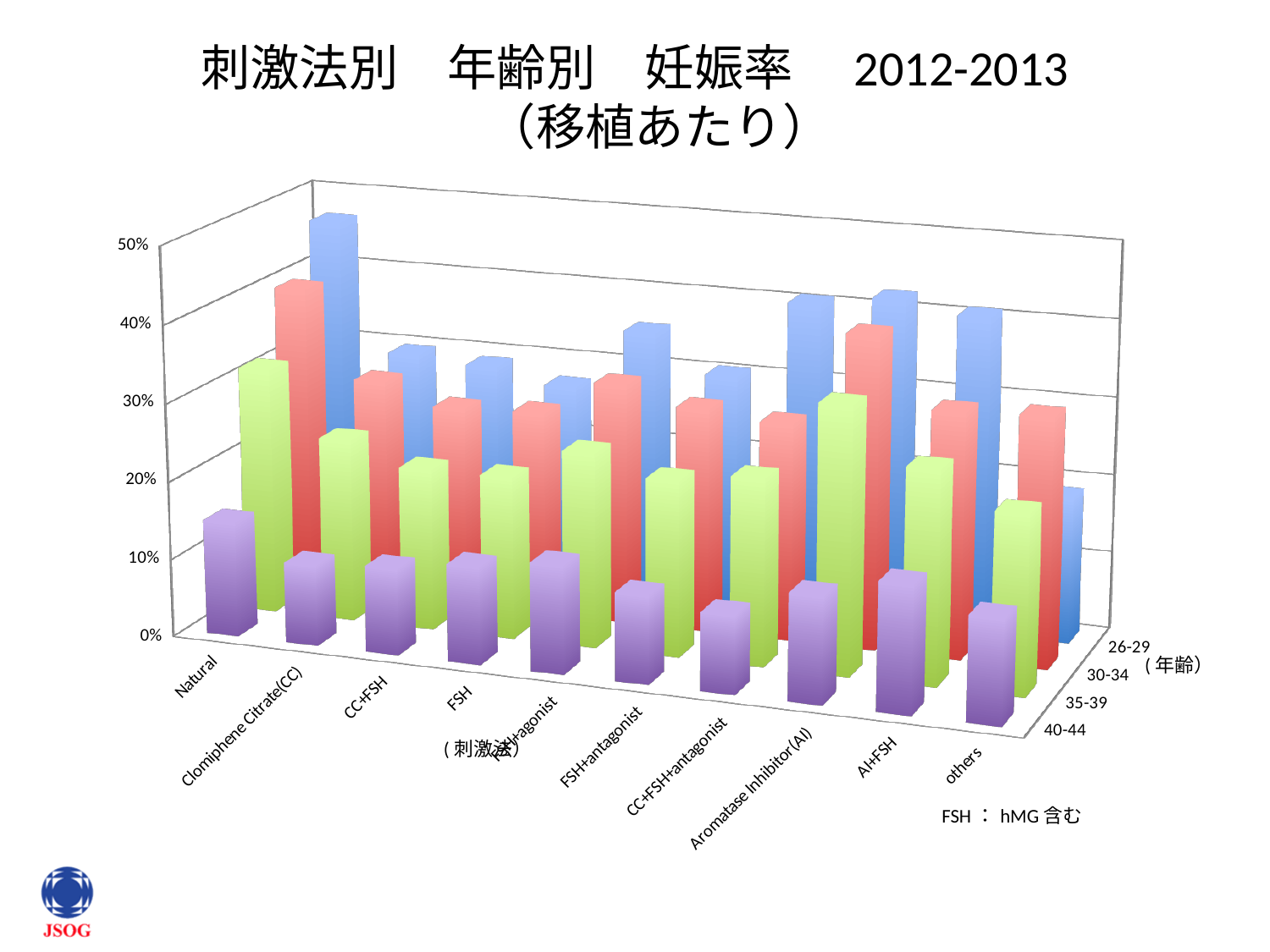
What years does the chart title say the data covers? 2012-2013 For which age group is the tallest bar in the chart plotted? 26-29 What kind of chart is shown on the slide? bar chart Which is larger, the 26-29 bar for Natural or the 26-29 bar for Clomiphene Citrate(CC)? Natural How many stimulation methods (刺激法) are shown along the x axis of the chart? 10 Which stimulation method has the tallest bar in the chart? Natural What is the highest percentage tick shown on the vertical axis? 50% Which age group generally has the lowest pregnancy rates across the stimulation methods? 40-44 How many age groups (年齢) are plotted in the chart? 4